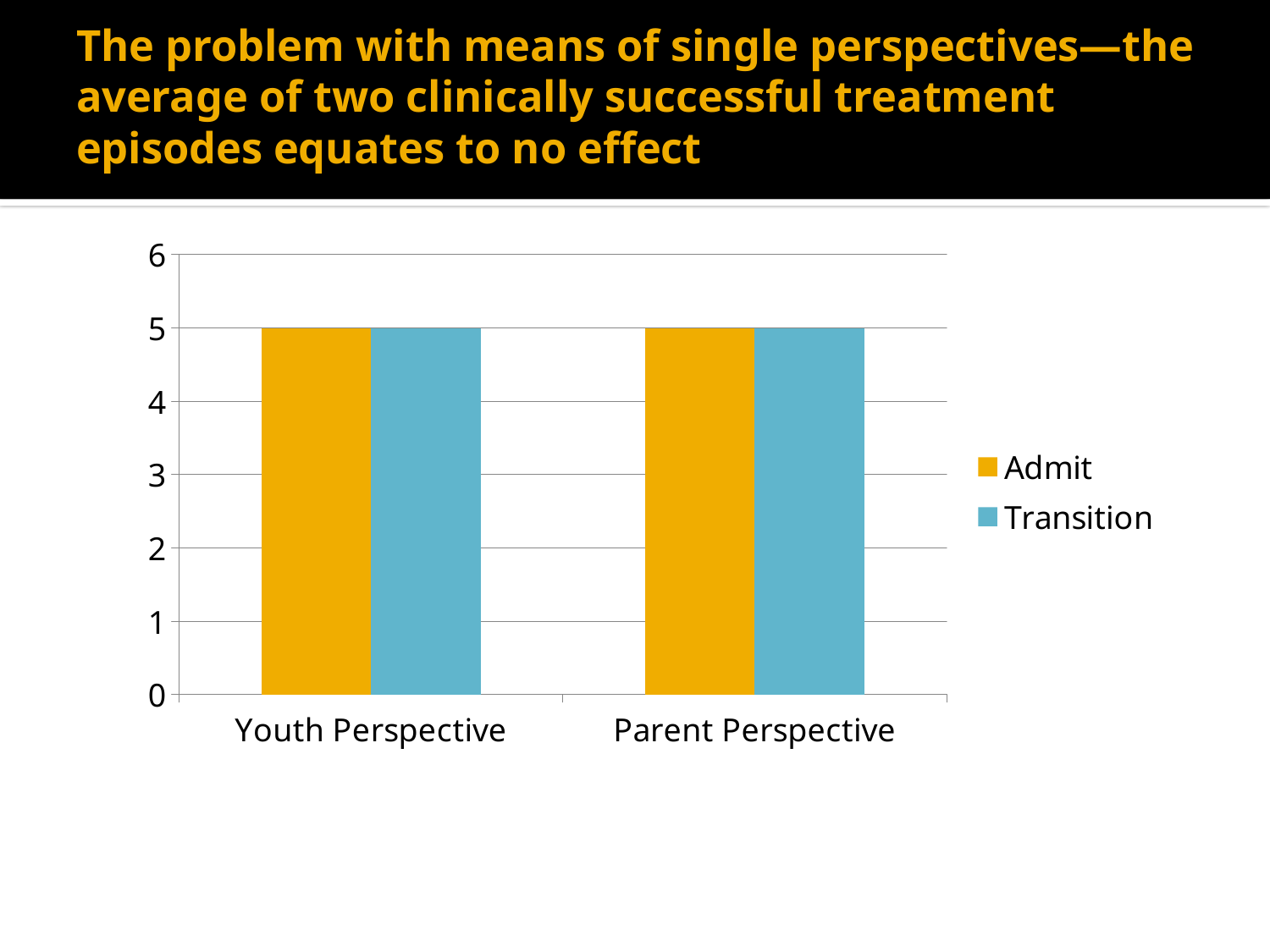
Is the Admit value for Youth Perspective greater or less than 6? less What is the difference between the Admit value for Youth Perspective and the Admit value for Parent Perspective? 0 Is the Transition value for Parent Perspective greater or less than 4? greater Which series is shown in blue in the legend? Transition What is the Transition value for Youth Perspective? 5 How many categories are shown on the x axis? 2 What is the Transition value for Parent Perspective? 5 What is the Admit value for Parent Perspective? 5 How many series does the legend list? 2 What is the difference between the Admit and Transition values for Youth Perspective? 0 What is the Admit value for Youth Perspective? 5 What kind of chart is shown on the slide? bar chart